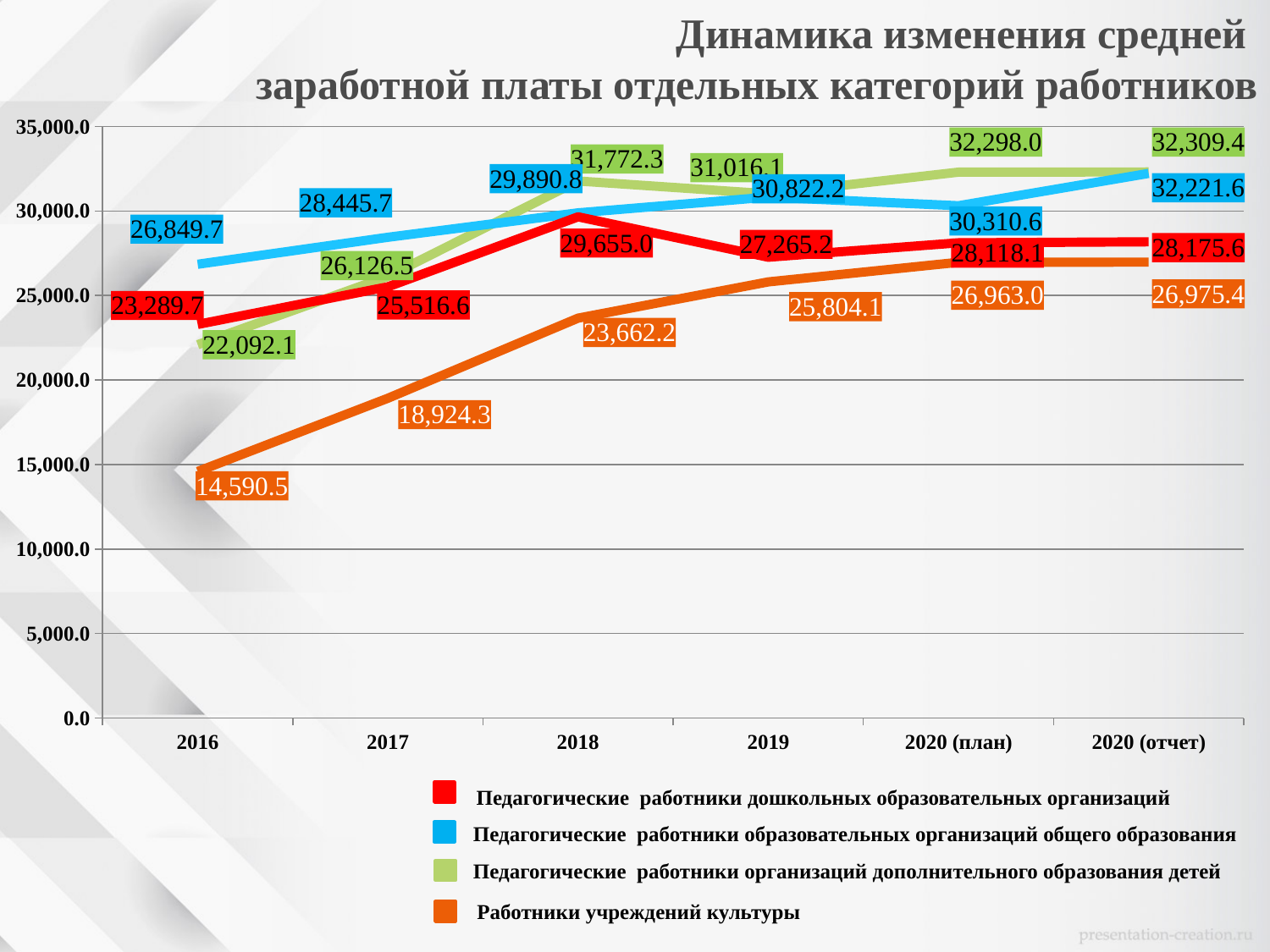
How many series does the legend list? 4 What kind of chart is shown on the slide? Line chart Do the values for Работники учреждений культуры rise or fall from 2016 to 2020 (отчет)? Rise What is the value for Работники учреждений культуры in 2016? 14,590.5 What is the difference between the 2017 and 2016 values for Работники учреждений культуры? 4,333.8 In 2018, which is larger: the value for Педагогические работники дошкольных образовательных организаций or for Педагогические работники образовательных организаций общего образования? Педагогические работники образовательных организаций общего образования What is the value for Педагогические работники дошкольных образовательных организаций in 2019? 27,265.2 What is the value for Педагогические работники образовательных организаций общего образования in 2020 (отчет)? 32,221.6 What is the value for Педагогические работники организаций дополнительного образования детей in 2018? 31,772.3 In which year is the value for Педагогические работники организаций дополнительного образования детей the highest? 2020 (отчет) How many categories are shown on the x axis? 6 In which year is the value for Педагогические работники дошкольных образовательных организаций the lowest? 2016